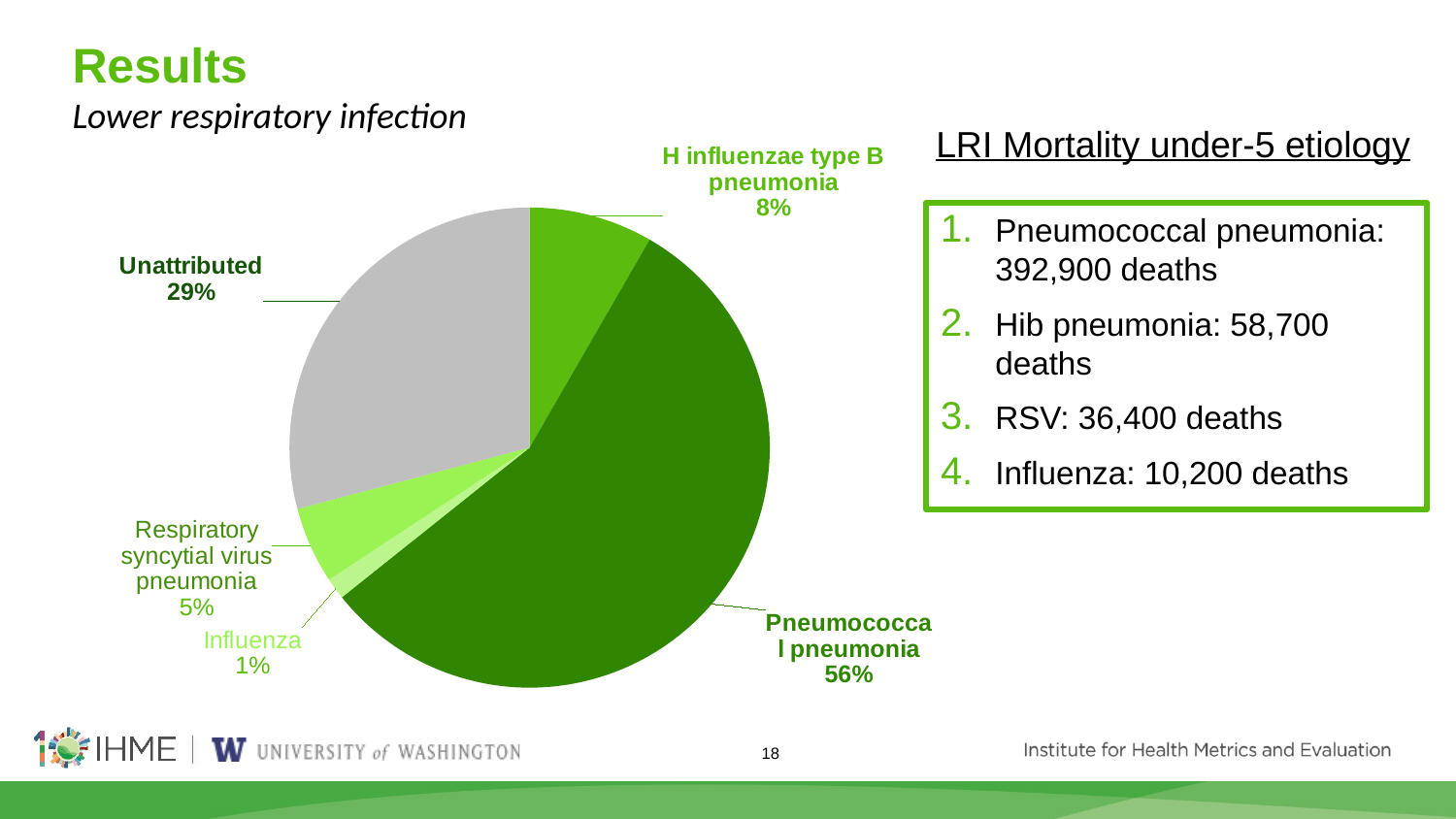
Which is larger, the share for H influenzae type B pneumonia or the share for Respiratory syncytial virus pneumonia? H influenzae type B pneumonia What percentage is shown for Influenza? 1% What percentage is shown for Respiratory syncytial virus pneumonia? 5% What is the difference in percentage points between Respiratory syncytial virus pneumonia and Influenza? 4 What percentage is shown for H influenzae type B pneumonia? 8% Which slice of the pie is the smallest? Influenza What is the difference in percentage points between Pneumococcal pneumonia and Unattributed? 27 What kind of chart is shown on the slide? Pie chart What share of the pie does Pneumococcal pneumonia account for? 56% How many slices does the pie chart have? 5 What percentage is shown for Unattributed? 29% Which slice of the pie is the largest? Pneumococcal pneumonia